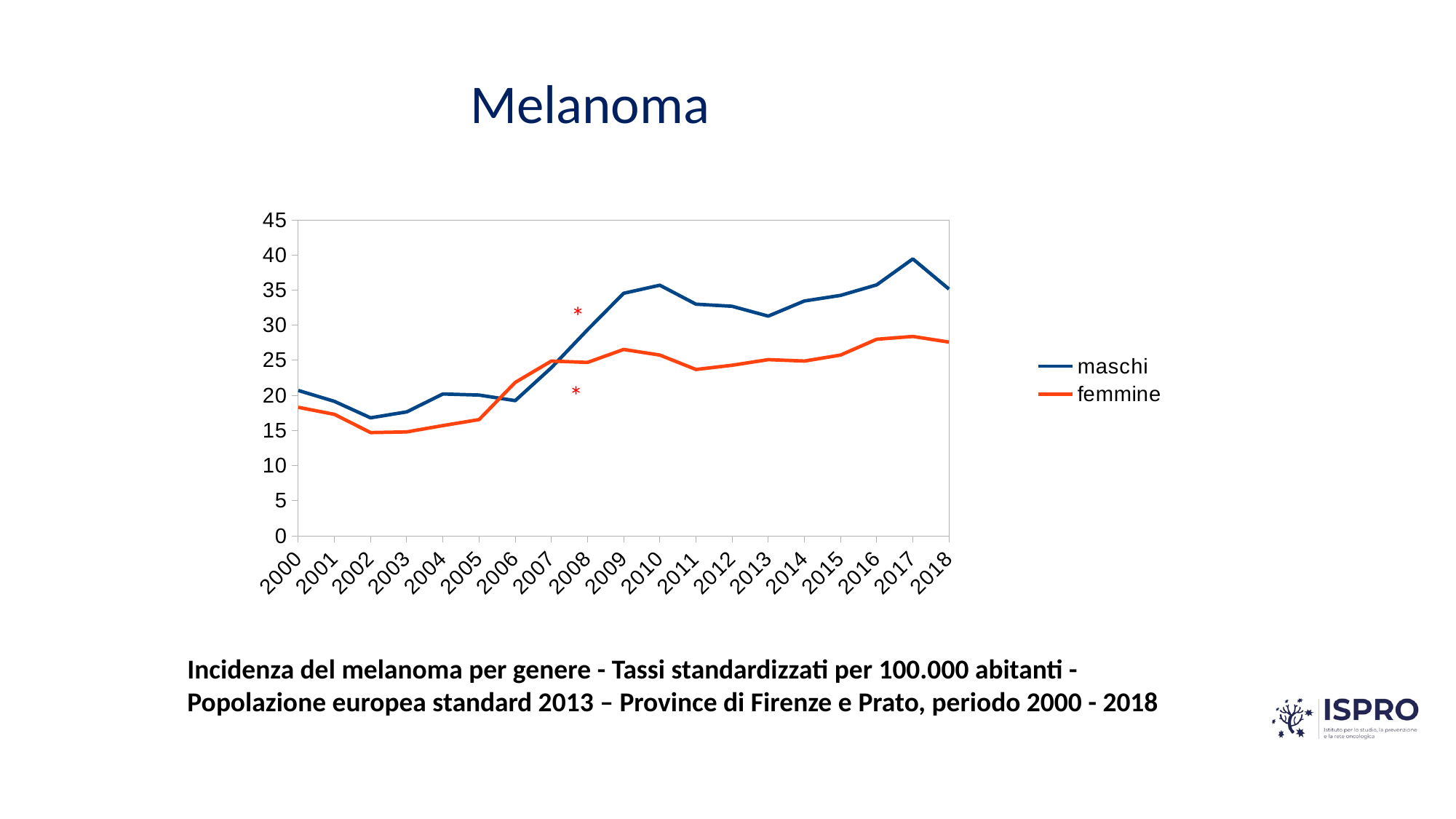
How many series does the legend list? 2 Which year has the lowest value for maschi? 2002 What are the two entries in the legend? maschi, femmine How many years are shown on the x axis? 19 Does the maschi line rise or fall between 2006 and 2010? rise In 2018, which series has the larger value, maschi or femmine? maschi Which year has the highest value for maschi? 2017 What kind of chart is shown on the slide? line chart Is the value for maschi in 2013 greater or less than 30? greater Is the value for maschi in 2017 greater or less than 35? greater Is the value for femmine in 2011 greater or less than 25? less